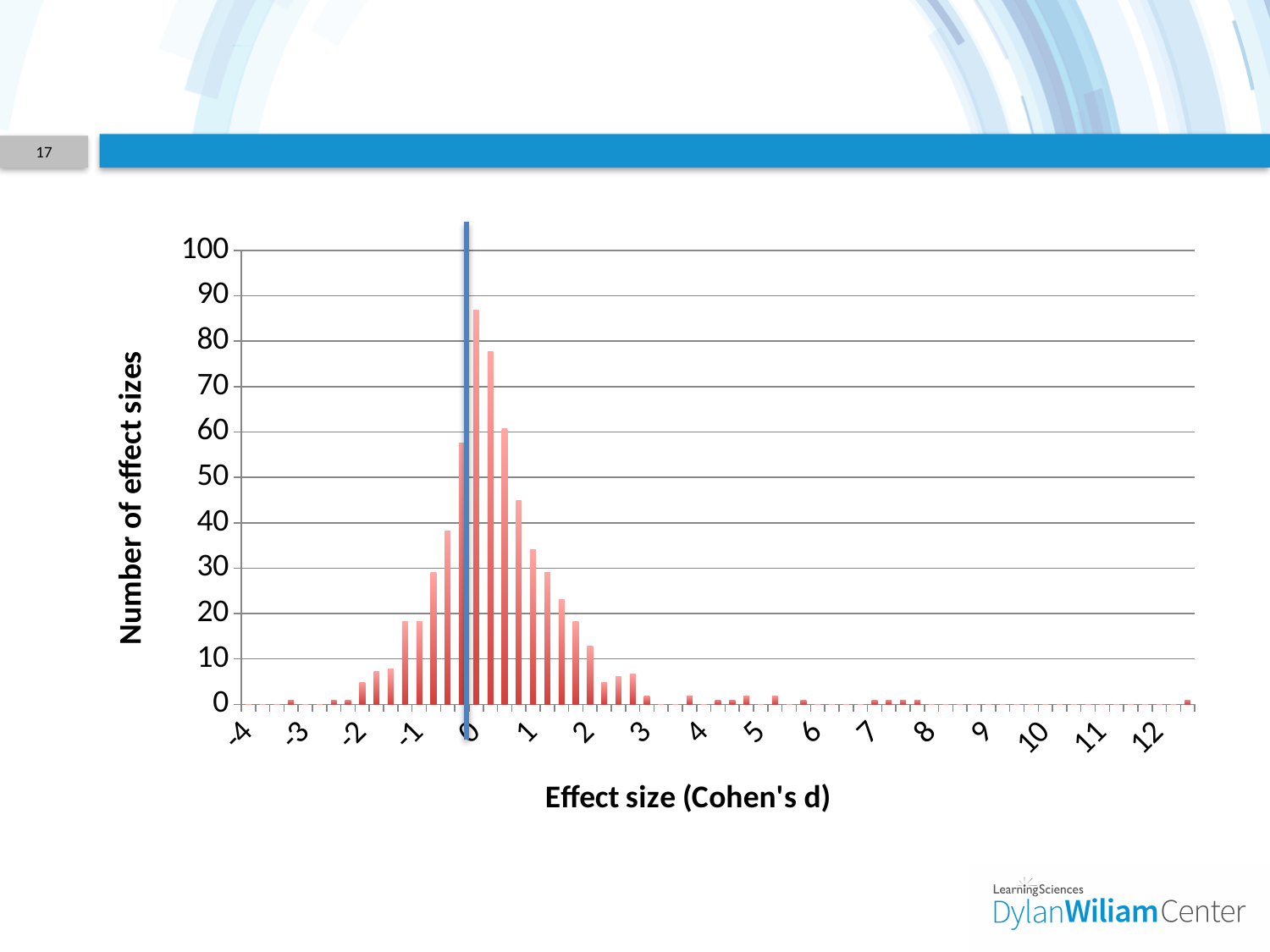
Are the bars around effect size 1 taller or shorter than the bars around effect size -2? taller Is the value of the tallest bar greater or less than 90? less What is the title of the y axis of the chart? Number of effect sizes Is the bar just to the left of the blue vertical line at 0 greater or less than 50? greater Are the bars at effect sizes of 4 and above greater or less than 10? less What kind of chart is shown on the slide? bar chart Do the bar heights rise or fall as the effect size increases from -2 to 0? rise What is the title of the x axis of the chart? Effect size (Cohen's d) Do the bar heights rise or fall as the effect size increases from 1 to 3? fall